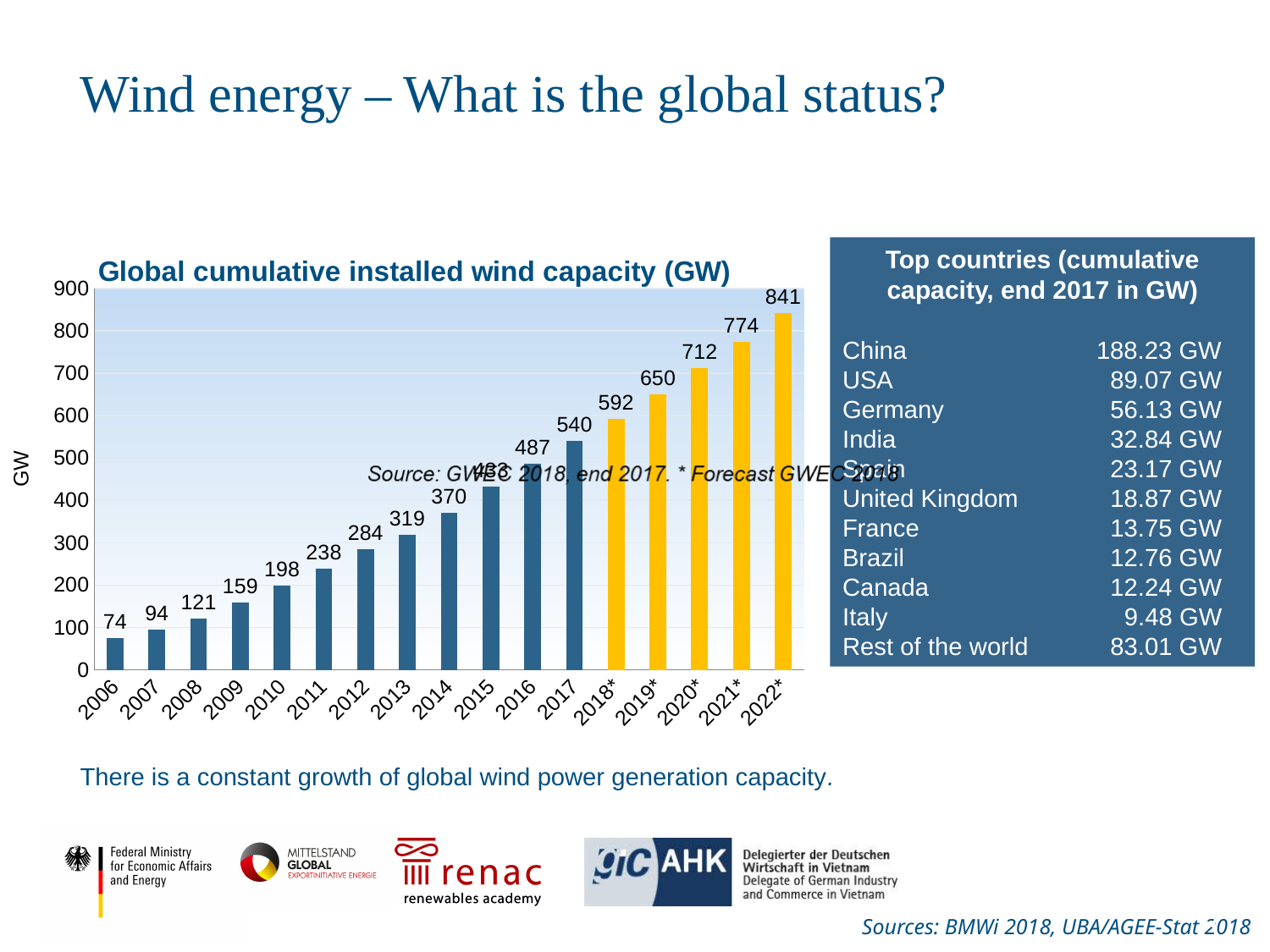
What is the global cumulative installed wind capacity shown for 2012? 284 How many years are shown on the x axis of the global cumulative installed wind capacity chart? 17 What is the forecast global cumulative installed wind capacity shown for 2022*? 841 By how much does the global cumulative installed wind capacity in 2017 exceed that of 2006? 466 What is the global cumulative installed wind capacity shown for 2006? 74 What kind of chart is 'Global cumulative installed wind capacity (GW)'? bar chart What is the difference between the forecast value for 2022* and the value for 2017 in the global cumulative installed wind capacity chart? 301 Which is larger in the global cumulative installed wind capacity chart, the value for 2014 or the value for 2013? 2014 What is the global cumulative installed wind capacity shown for 2017? 540 Do the values in the global cumulative installed wind capacity chart rise or fall from 2006 to 2022*? rise Which year has the highest value in the global cumulative installed wind capacity chart? 2022* Which year has the lowest value in the global cumulative installed wind capacity chart? 2006